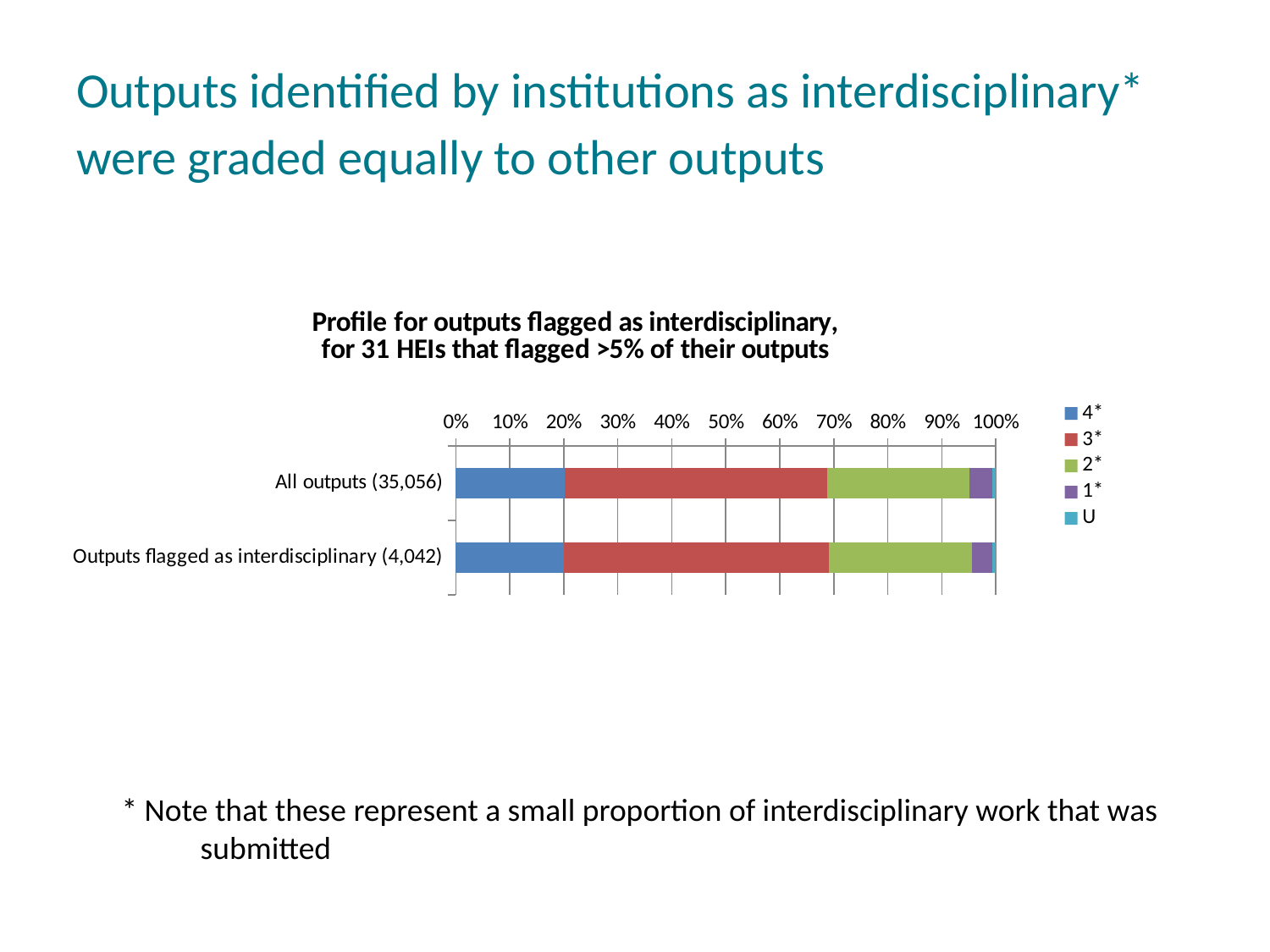
Is the 1* share for All outputs (35,056) greater or less than 10%? less Which series is listed first in the chart legend? 4* Is the 3* share for All outputs (35,056) greater or less than 40%? greater Is the 2* share for Outputs flagged as interdisciplinary (4,042) greater or less than 20%? greater For Outputs flagged as interdisciplinary (4,042), which is larger: the 3* share or the 2* share? 3* What is the title of the chart? Profile for outputs flagged as interdisciplinary, for 31 HEIs that flagged >5% of their outputs How many categories (bars) are plotted in the chart? 2 How many series does the legend list? 5 Which series takes up the largest share of the bar for All outputs (35,056)? 3* What kind of chart is shown on the slide? Stacked bar chart